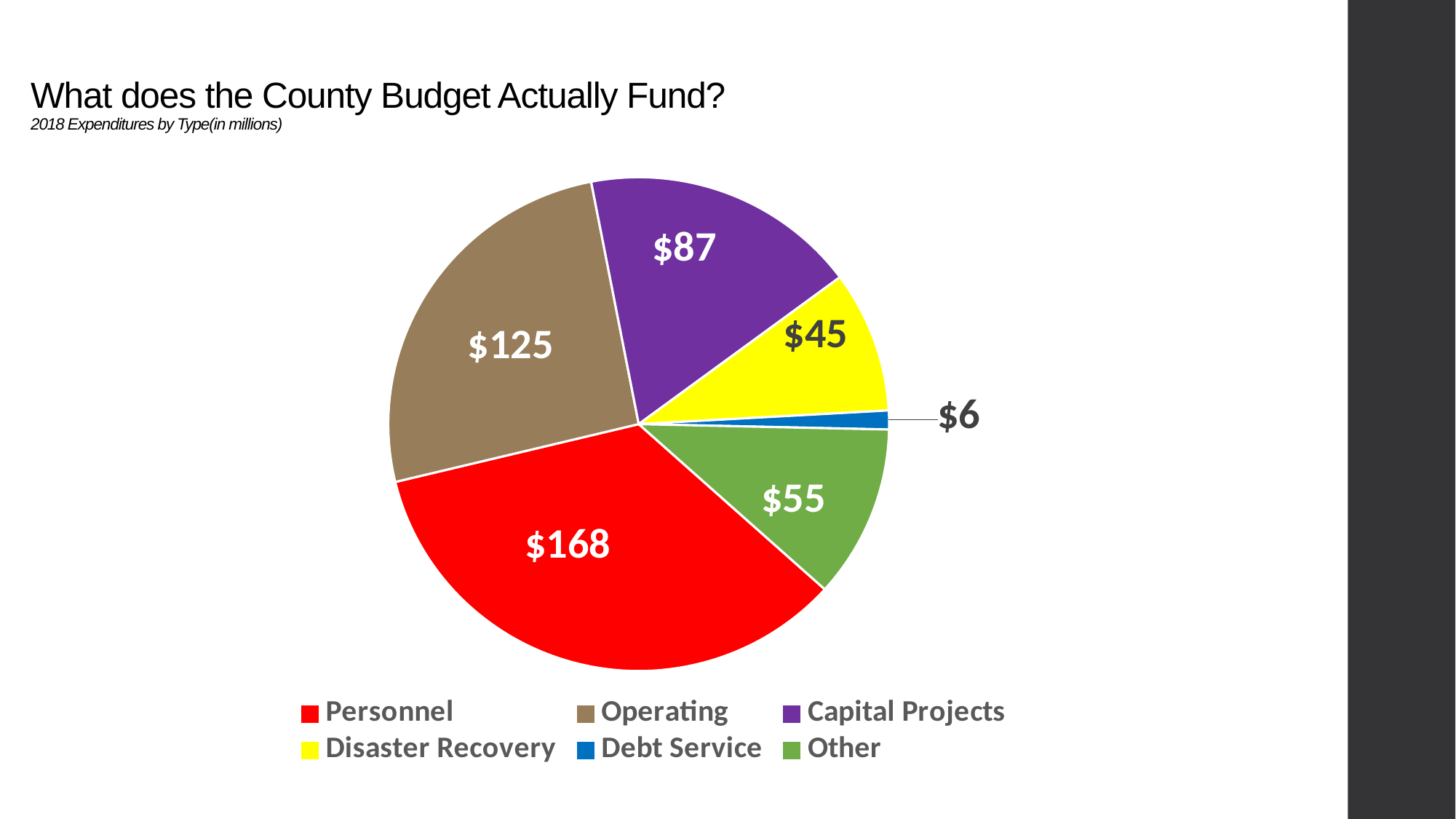
Which expenditure type has the largest slice of the pie? Personnel What is the difference between the Personnel and Operating values? $43 Which colour represents Operating in the legend? Brown Which is larger, Disaster Recovery or Other? Other What is the total of all the slices in the pie chart? $486 How many categories are shown in the pie chart? 6 Which expenditure type has the smallest slice of the pie? Debt Service What is the value for Capital Projects? $87 What is the value for Personnel in the pie chart? $168 What is the value for Debt Service? $6 To the nearest whole percent, what share of the total does Personnel represent? 35% What kind of chart is shown on the slide? Pie chart